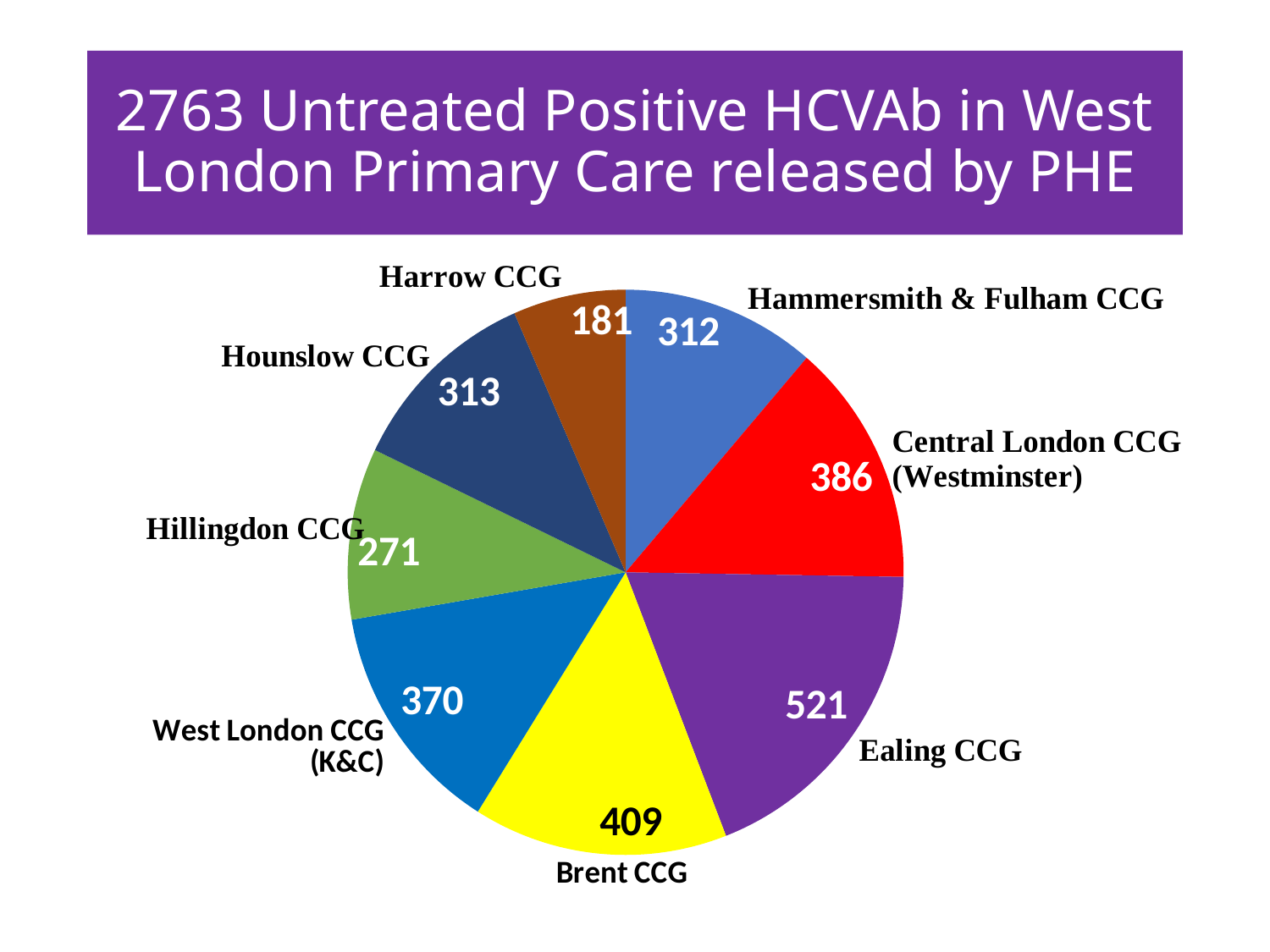
What colour is the Brent CCG slice? Yellow What type of chart is shown on the slide? Pie chart What is the total of all the slices in the pie chart? 2763 Which is larger, the value for Brent CCG or the value for Hillingdon CCG? Brent CCG What is the difference between the values for Ealing CCG and Brent CCG? 112 What is the value for Ealing CCG? 521 What is the value for Central London CCG (Westminster)? 386 How many CCG slices does the pie chart have? 8 What is the value for Harrow CCG? 181 What is the value for West London CCG (K&C)? 370 Which CCG has the largest slice of the pie? Ealing CCG Which CCG has the smallest slice of the pie? Harrow CCG